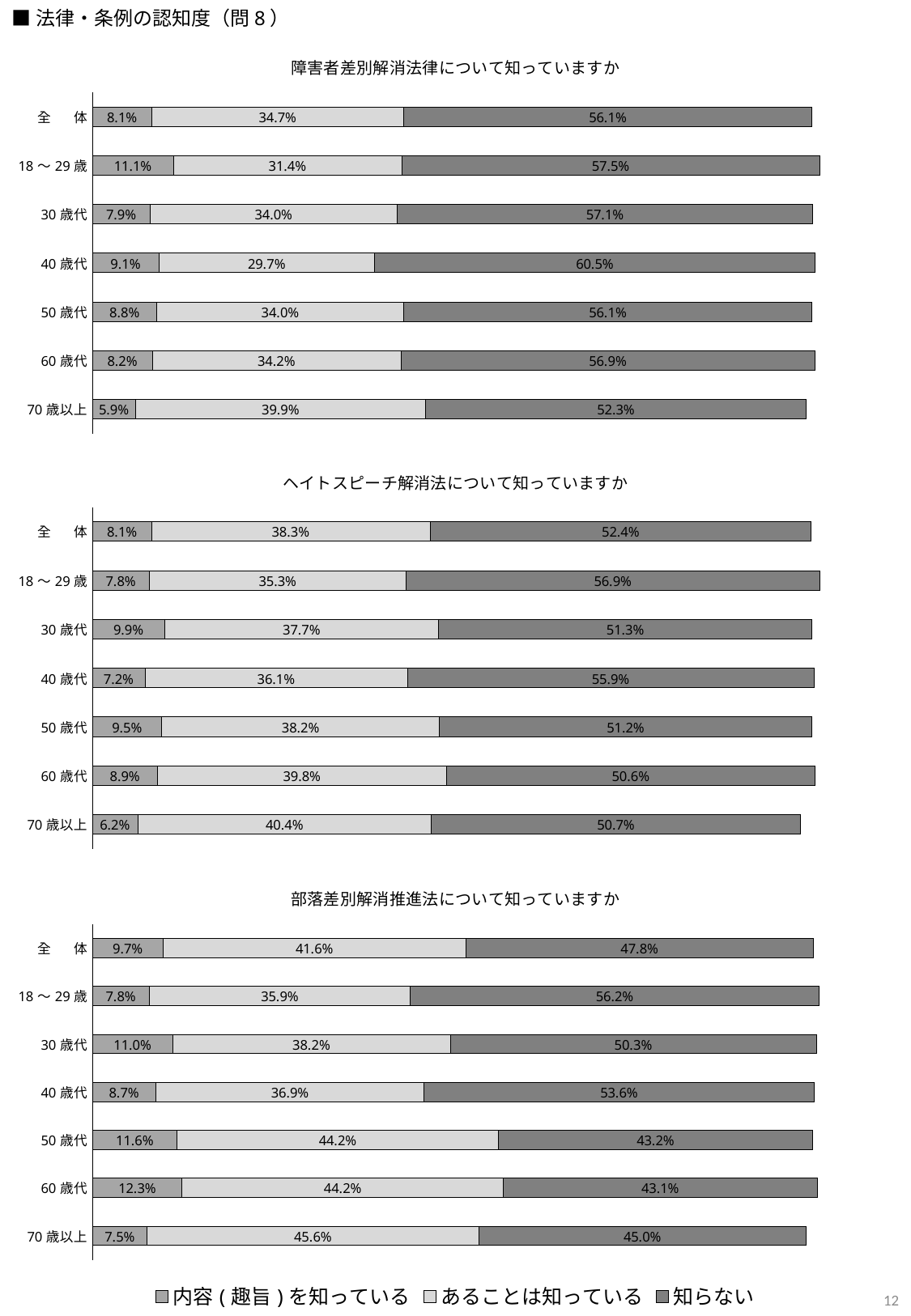
How many series does the legend at the bottom of the slide list? 3 In the chart titled ヘイトスピーチ解消法について知っていますか, which is larger, the 内容(趣旨)を知っている value for 30歳代 or for 40歳代? 30歳代 In the chart titled 部落差別解消推進法について知っていますか, which age group has the highest 知らない value? 18～29歳 What kind of chart is the chart titled ヘイトスピーチ解消法について知っていますか? Stacked bar chart In the chart titled 障害者差別解消法律について知っていますか, which age group has the highest 知らない value? 40歳代 In the chart titled 部落差別解消推進法について知っていますか, what is the difference between the あることは知っている values for 70歳以上 and 18～29歳? 9.7% In the chart titled 障害者差別解消法律について知っていますか, which category has the lowest 内容(趣旨)を知っている value? 70歳以上 In the chart titled 部落差別解消推進法について知っていますか, what is the 内容(趣旨)を知っている value for 60歳代? 12.3% How many categories are shown on the y axis of the chart titled 障害者差別解消法律について知っていますか? 7 In the chart titled 障害者差別解消法律について知っていますか, what is the 知らない value for 40歳代? 60.5% In the chart titled ヘイトスピーチ解消法について知っていますか, what is the difference between the 知らない values for 18～29歳 and 60歳代? 6.3% In the chart titled ヘイトスピーチ解消法について知っていますか, what is the あることは知っている value for 70歳以上? 40.4%